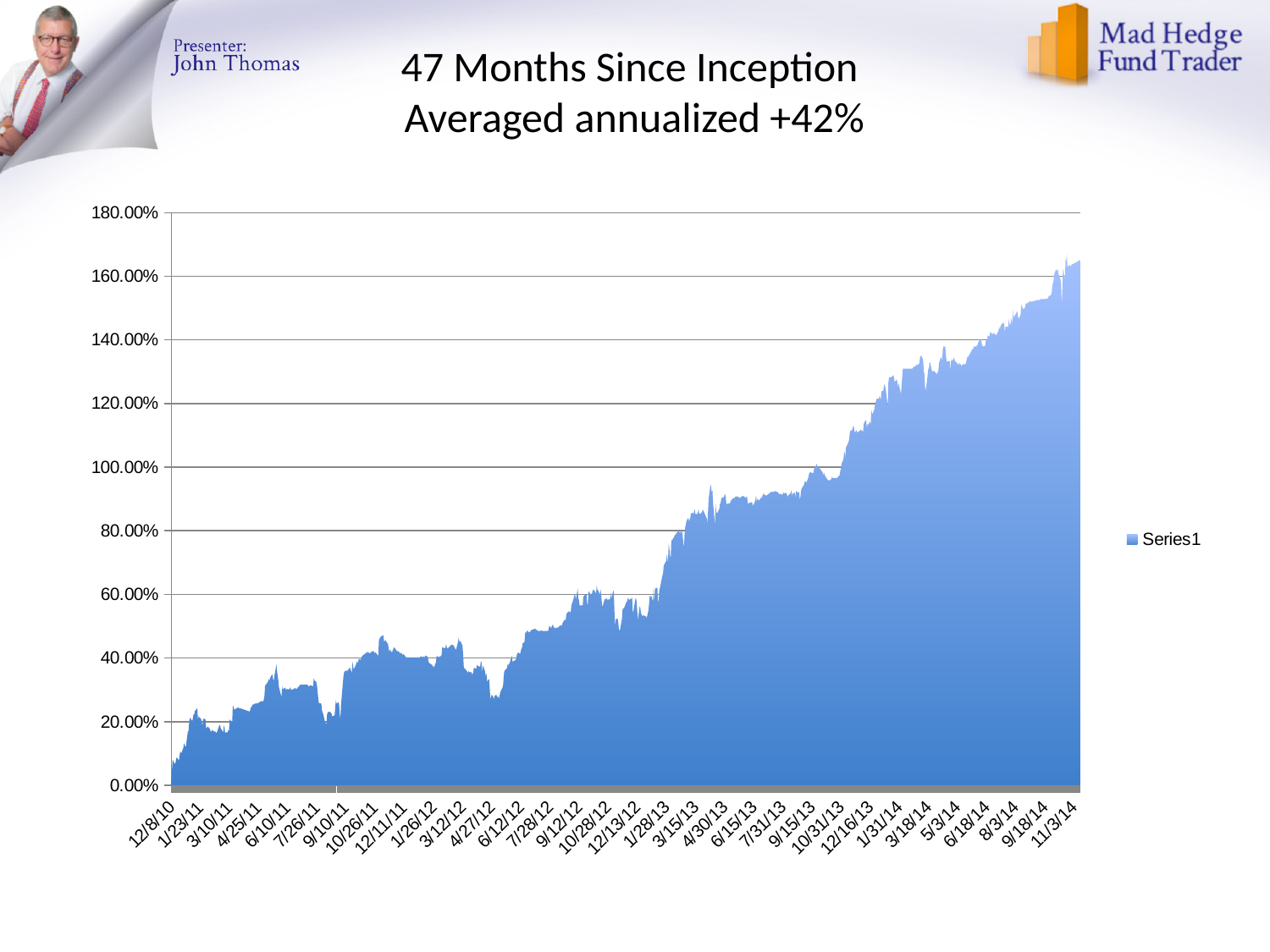
Is the value at 12/8/10 greater or less than 20.00%? less Is the value at 10/28/12 greater or less than 80.00%? less Do the values generally rise or fall from 12/8/10 to 11/3/14? Rise What is the title of the chart on the slide? 47 Months Since Inception Averaged annualized +42% Is the value at 1/31/14 greater or less than 120.00%? greater How many series does the legend list? 1 What is the name of the series shown in the legend? Series1 What kind of chart is shown on the slide? Area chart Which is larger, the value at 1/31/14 or the value at 6/12/12? 1/31/14 Which is larger, the value at 11/3/14 or the value at 12/8/10? 11/3/14